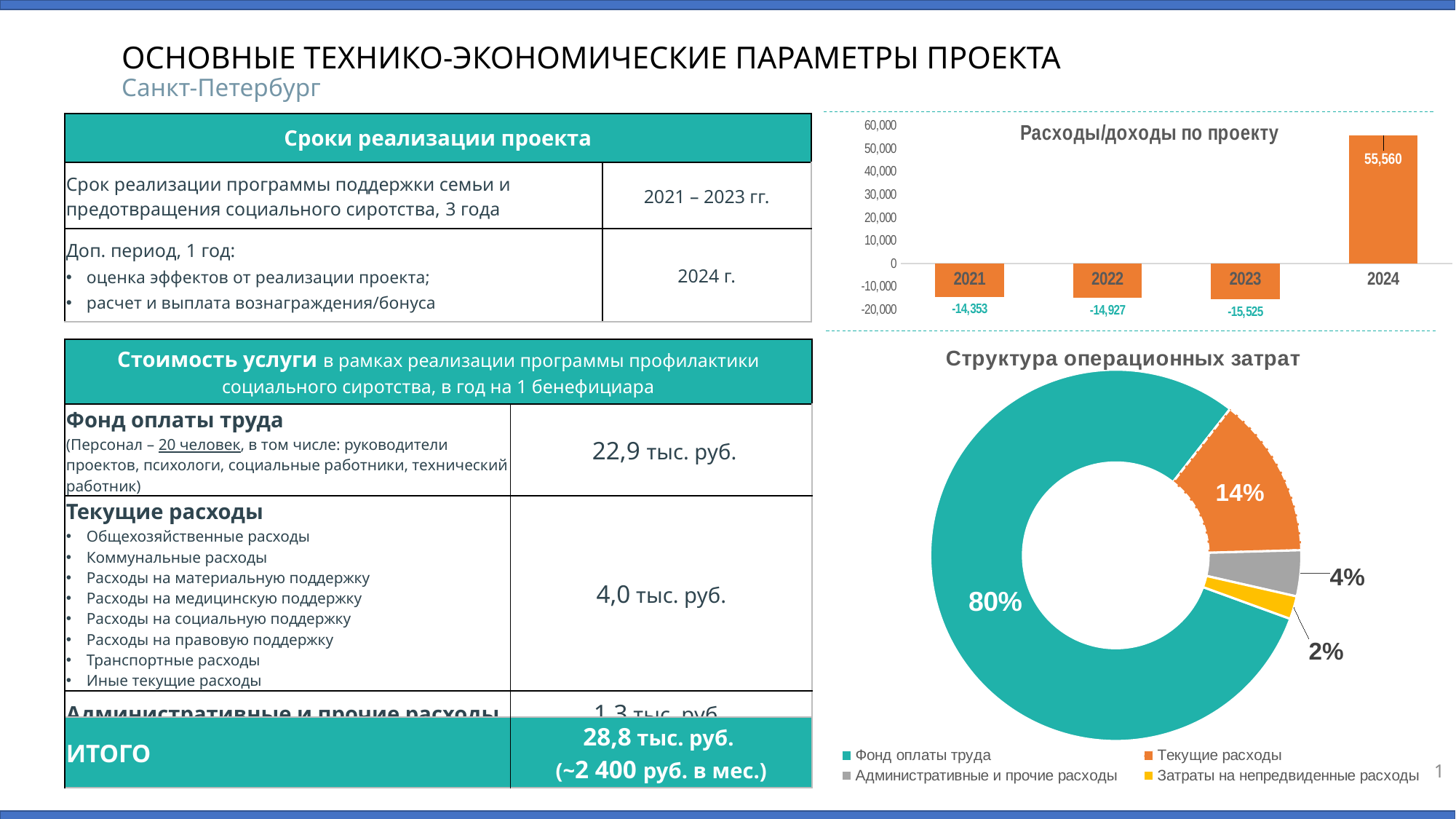
In the chart 'Структура операционных затрат', what share does 'Фонд оплаты труда' have? 80% In the chart 'Структура операционных затрат', what share does 'Текущие расходы' have? 14% In the chart 'Структура операционных затрат', which category has the smallest share? Затраты на непредвиденные расходы What kind of chart is 'Расходы/доходы по проекту'? bar chart In the chart 'Расходы/доходы по проекту', what is the value for 2024? 55,560 In the chart 'Расходы/доходы по проекту', what is the value for 2021? -14,353 How many categories does the legend of the chart 'Структура операционных затрат' list? 4 In the chart 'Расходы/доходы по проекту', what is the difference between the values for 2023 and 2022? 598 In the chart 'Расходы/доходы по проекту', which year has the lowest value? 2023 In the chart 'Расходы/доходы по проекту', which year has the highest value? 2024 In the chart 'Расходы/доходы по проекту', how many years are shown on the x axis? 4 In the chart 'Расходы/доходы по проекту', what is the value for 2023? -15,525